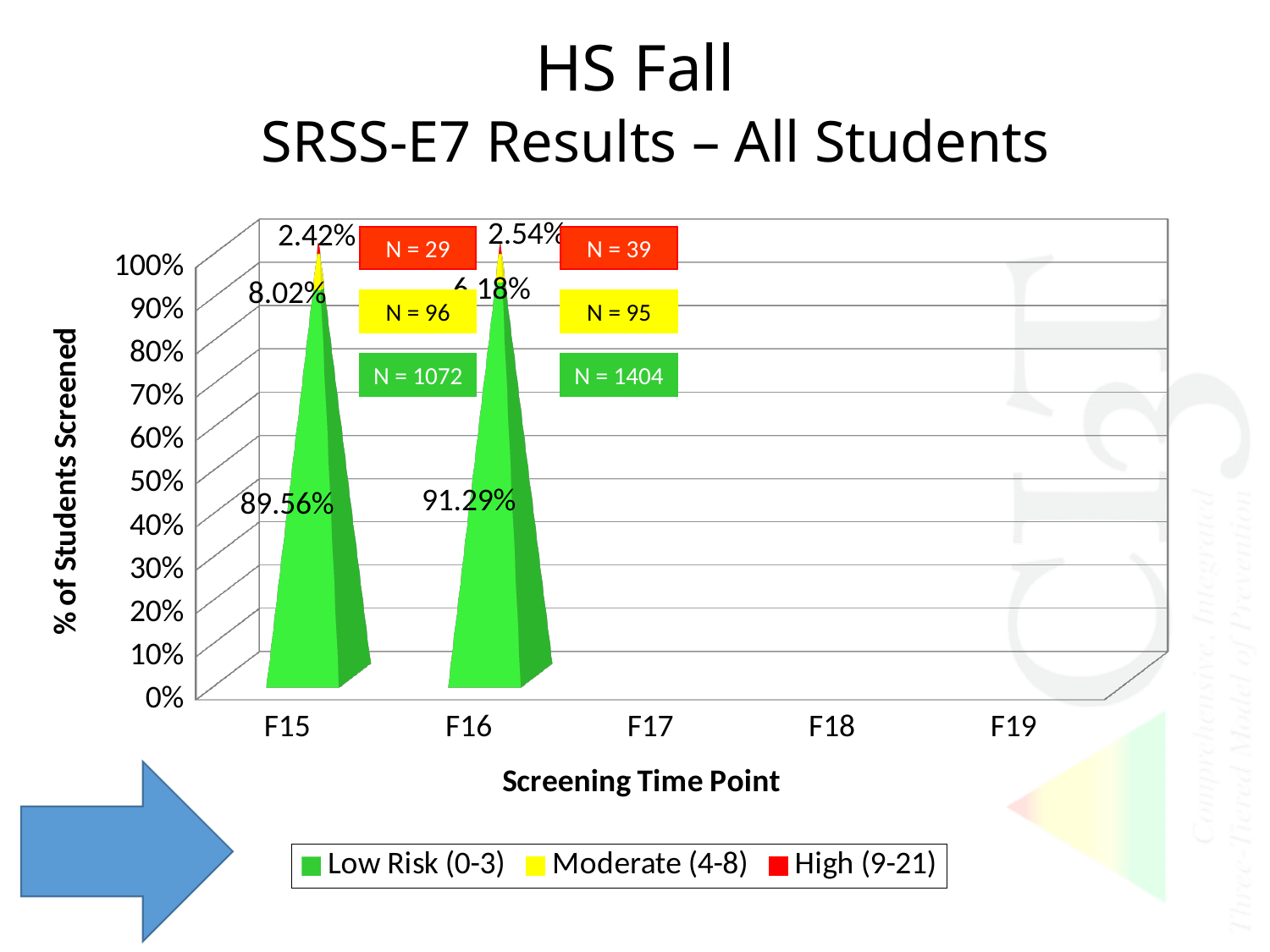
What percentage of students screened were High (9-21) at F16? 2.54% How many screening time points are labelled on the x axis? 5 Which screening time point has the higher Low Risk (0-3) percentage, F15 or F16? F16 By how many percentage points does the High (9-21) value at F16 exceed the value at F15? 0.12 percentage points What is the title of the y axis? % of Students Screened By how many percentage points does the Low Risk (0-3) value at F16 exceed the value at F15? 1.73 percentage points How many series does the legend list? 3 What percentage of students screened were Low Risk (0-3) at F16? 91.29% What percentage of students screened were High (9-21) at F15? 2.42% What is the total of the stacked values at F15 (Low Risk, Moderate and High combined)? 100% What percentage of students screened were Low Risk (0-3) at F15? 89.56% What percentage of students screened were Moderate (4-8) at F15? 8.02%